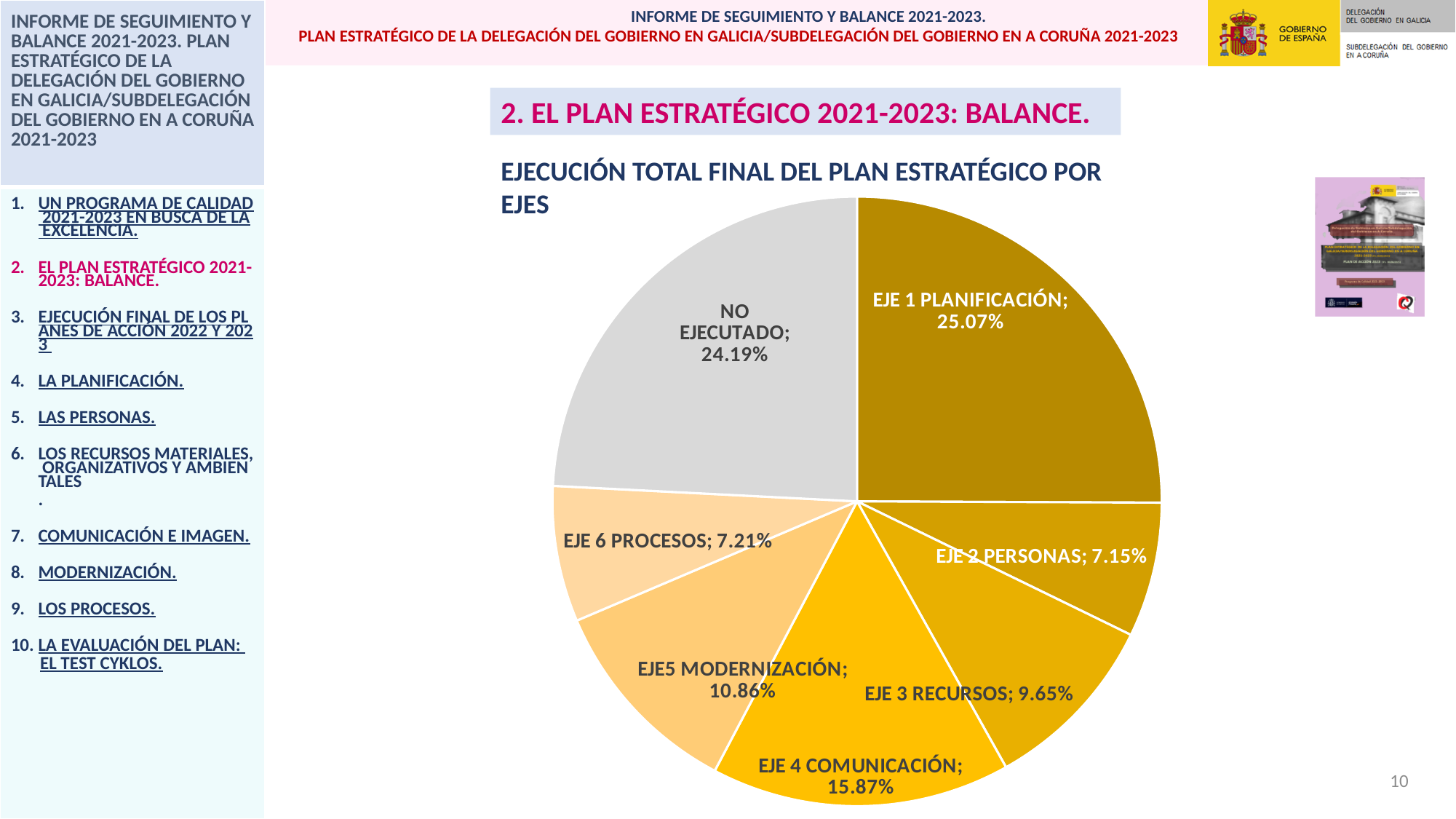
What percentage is shown for EJE 3 RECURSOS? 9.65% Which is larger, the share for EJE 6 PROCESOS or the share for EJE 2 PERSONAS? EJE 6 PROCESOS Which slice has the smallest share of the pie? EJE 2 PERSONAS How many slices does the pie chart have? 7 What percentage is shown for NO EJECUTADO? 24.19% What percentage is shown for EJE 1 PLANIFICACIÓN? 25.07% What is the title of the chart? EJECUCIÓN TOTAL FINAL DEL PLAN ESTRATÉGICO POR EJES What type of chart is shown on the slide? Pie chart What percentage is shown for EJE5 MODERNIZACIÓN? 10.86% Which slice has the largest share of the pie? EJE 1 PLANIFICACIÓN What percentage is shown for EJE 4 COMUNICACIÓN? 15.87% What is the difference in percentage points between EJE 4 COMUNICACIÓN and EJE 3 RECURSOS? 6.22